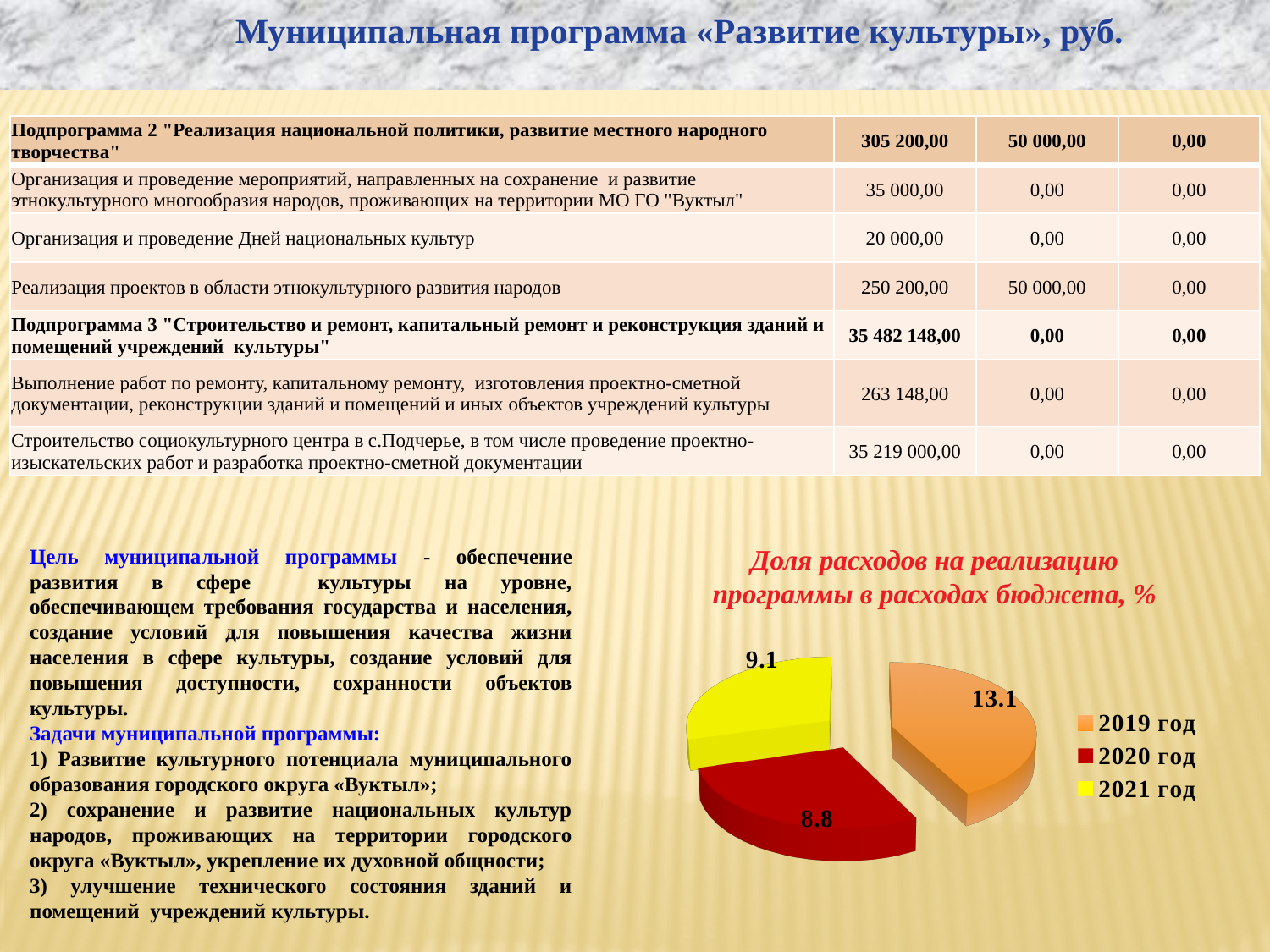
Which year has the largest slice in the pie chart? 2019 год What is the title of the pie chart? Доля расходов на реализацию программы в расходах бюджета, % What value is shown for 2020 год in the pie chart? 8.8 What is the difference between the values for 2021 год and 2020 год in the pie chart? 0.3 What colour is the slice for 2020 год in the pie chart? red Which is larger in the pie chart, the value for 2019 год or 2021 год? 2019 год What is the difference between the values for 2019 год and 2020 год in the pie chart? 4.3 What value is shown for 2021 год in the pie chart? 9.1 How many slices does the pie chart have? 3 What value is shown for 2019 год in the pie chart? 13.1 Which year has the smallest slice in the pie chart? 2020 год What type of chart is shown on the slide? pie chart